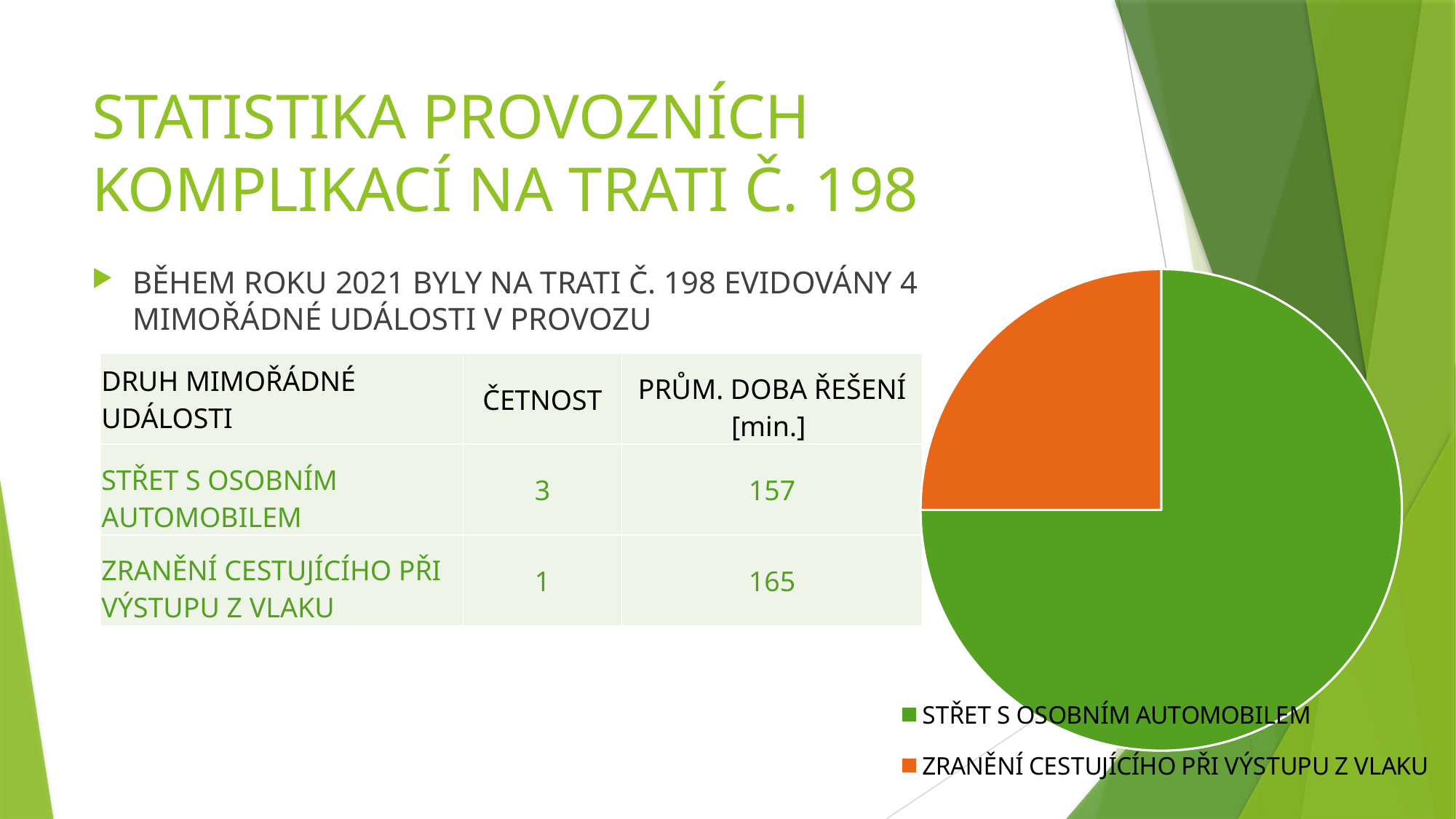
According to the table, how many events does the ZRANĚNÍ CESTUJÍCÍHO PŘI VÝSTUPU Z VLAKU slice represent? 1 What colour is the slice for ZRANĚNÍ CESTUJÍCÍHO PŘI VÝSTUPU Z VLAKU? orange What colour is the slice for STŘET S OSOBNÍM AUTOMOBILEM? green How many slices does the pie chart have? 2 What kind of chart is shown on the slide? pie chart What share of the pie does the STŘET S OSOBNÍM AUTOMOBILEM slice take, based on the counts in the table? 75% According to the table, how many events does the STŘET S OSOBNÍM AUTOMOBILEM slice represent? 3 Which slice is larger: STŘET S OSOBNÍM AUTOMOBILEM or ZRANĚNÍ CESTUJÍCÍHO PŘI VÝSTUPU Z VLAKU? STŘET S OSOBNÍM AUTOMOBILEM How many entries does the legend of the pie chart list? 2 What share of the pie does the ZRANĚNÍ CESTUJÍCÍHO PŘI VÝSTUPU Z VLAKU slice take, based on the counts in the table? 25% Which category has the largest slice in the pie chart? STŘET S OSOBNÍM AUTOMOBILEM Which category has the smallest slice in the pie chart? ZRANĚNÍ CESTUJÍCÍHO PŘI VÝSTUPU Z VLAKU